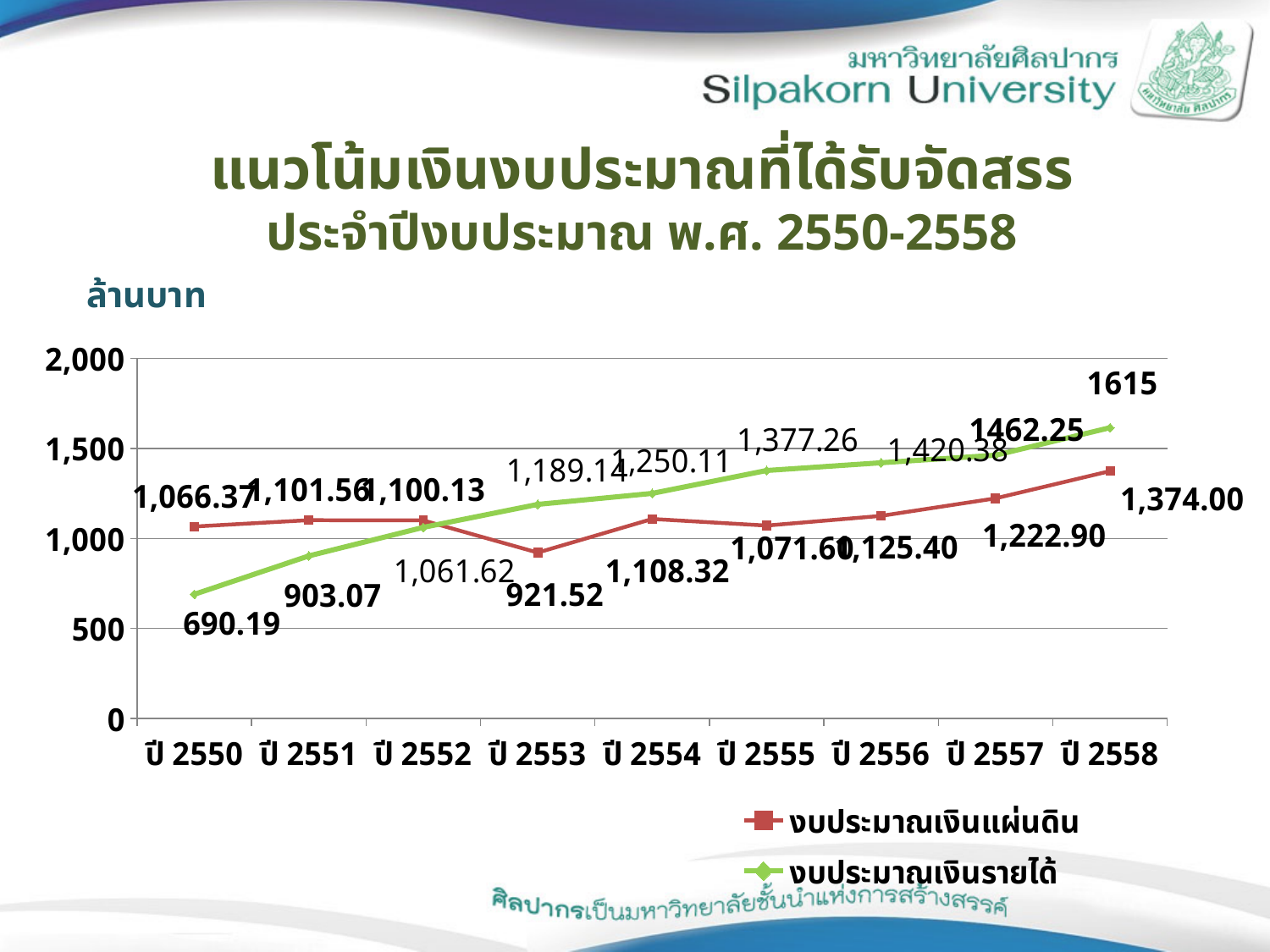
Does งบประมาณเงินรายได้ rise or fall from ปี 2550 to ปี 2558? rise In which year is งบประมาณเงินรายได้ highest? ปี 2558 What is the value of งบประมาณเงินแผ่นดิน for ปี 2553? 921.52 In ปี 2558, which series has the larger value, งบประมาณเงินแผ่นดิน or งบประมาณเงินรายได้? งบประมาณเงินรายได้ How many fiscal years are plotted along the x axis? 9 In which year is งบประมาณเงินแผ่นดิน lowest? ปี 2553 How many series does the legend list? 2 What is the difference between งบประมาณเงินแผ่นดิน in ปี 2558 and ปี 2557? 151.10 What is the value of งบประมาณเงินรายได้ for ปี 2558? 1615 What is the value of งบประมาณเงินแผ่นดิน for ปี 2558? 1,374.00 What is the value of งบประมาณเงินรายได้ for ปี 2550? 690.19 What type of chart is shown on the slide? line chart